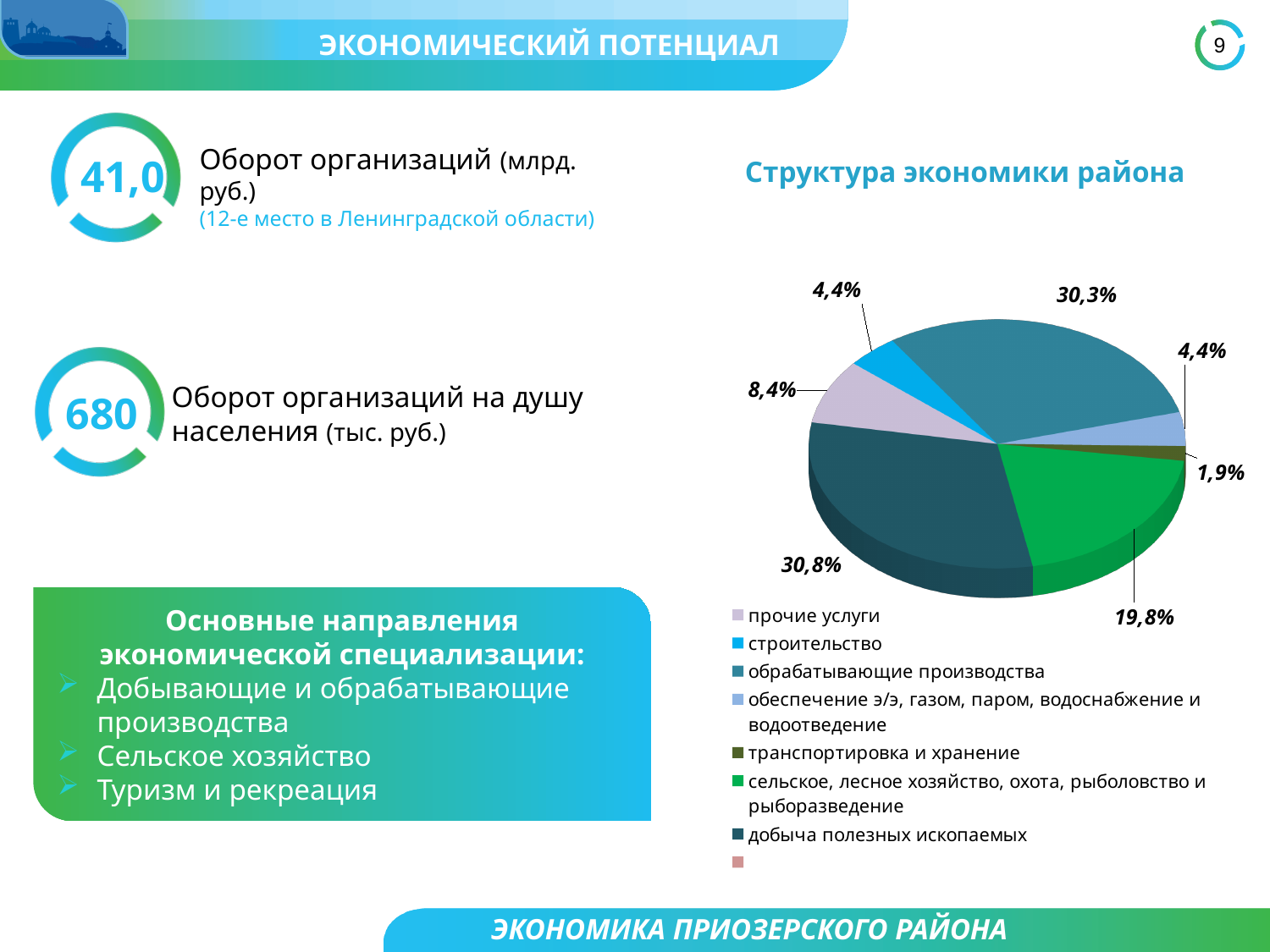
In the pie chart «Структура экономики района», what is the difference between the shares of «добыча полезных ископаемых» and «сельское, лесное хозяйство, охота, рыболовство и рыборазведение»? 11,0% In the pie chart «Структура экономики района», which category has the largest labelled share? добыча полезных ископаемых In the pie chart «Структура экономики района», what share is labelled for «сельское, лесное хозяйство, охота, рыболовство и рыборазведение»? 19,8% In the pie chart «Структура экономики района», what share is labelled for «добыча полезных ископаемых»? 30,8% In the pie chart «Структура экономики района», which share is larger: «строительство» or «прочие услуги»? прочие услуги In the pie chart «Структура экономики района», what share is labelled for «прочие услуги»? 8,4% In the pie chart «Структура экономики района», which category has the smallest share? транспортировка и хранение In the pie chart «Структура экономики района», what share is labelled for «обрабатывающие производства»? 30,3% In the pie chart «Структура экономики района», what share is labelled for «транспортировка и хранение»? 1,9% What type of chart is shown under the title «Структура экономики района»? pie chart How many slices with percentage labels does the pie chart «Структура экономики района» have? 7 In the pie chart «Структура экономики района», what colour is the slice for «сельское, лесное хозяйство, охота, рыболовство и рыборазведение»? green